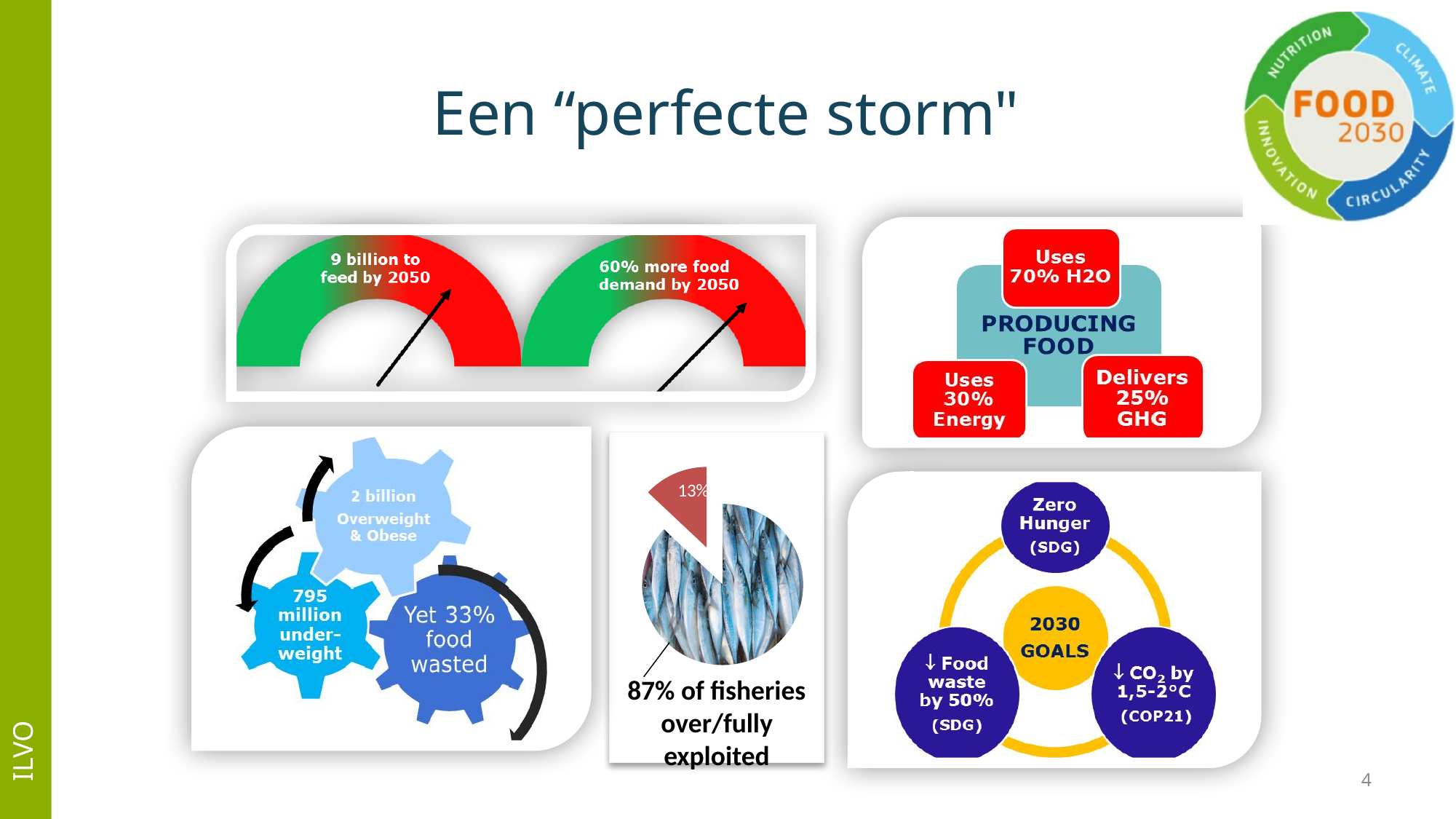
In the pie chart, which slice is larger: the 13% slice or the slice covered by the fish image? the slice covered by the fish image What colour is the small 13% slice of the pie chart? red What kind of chart is shown in the middle-bottom panel with the fish image? pie chart According to the caption under the pie chart, what percentage of fisheries are over/fully exploited? 87% What image fills the large slice of the pie chart? fish In the pie chart, what share is shown on the small exploded slice? 13% How many slices does the pie chart have? 2 What is the difference in percentage points between the 87% share and the 13% share in the pie chart? 74